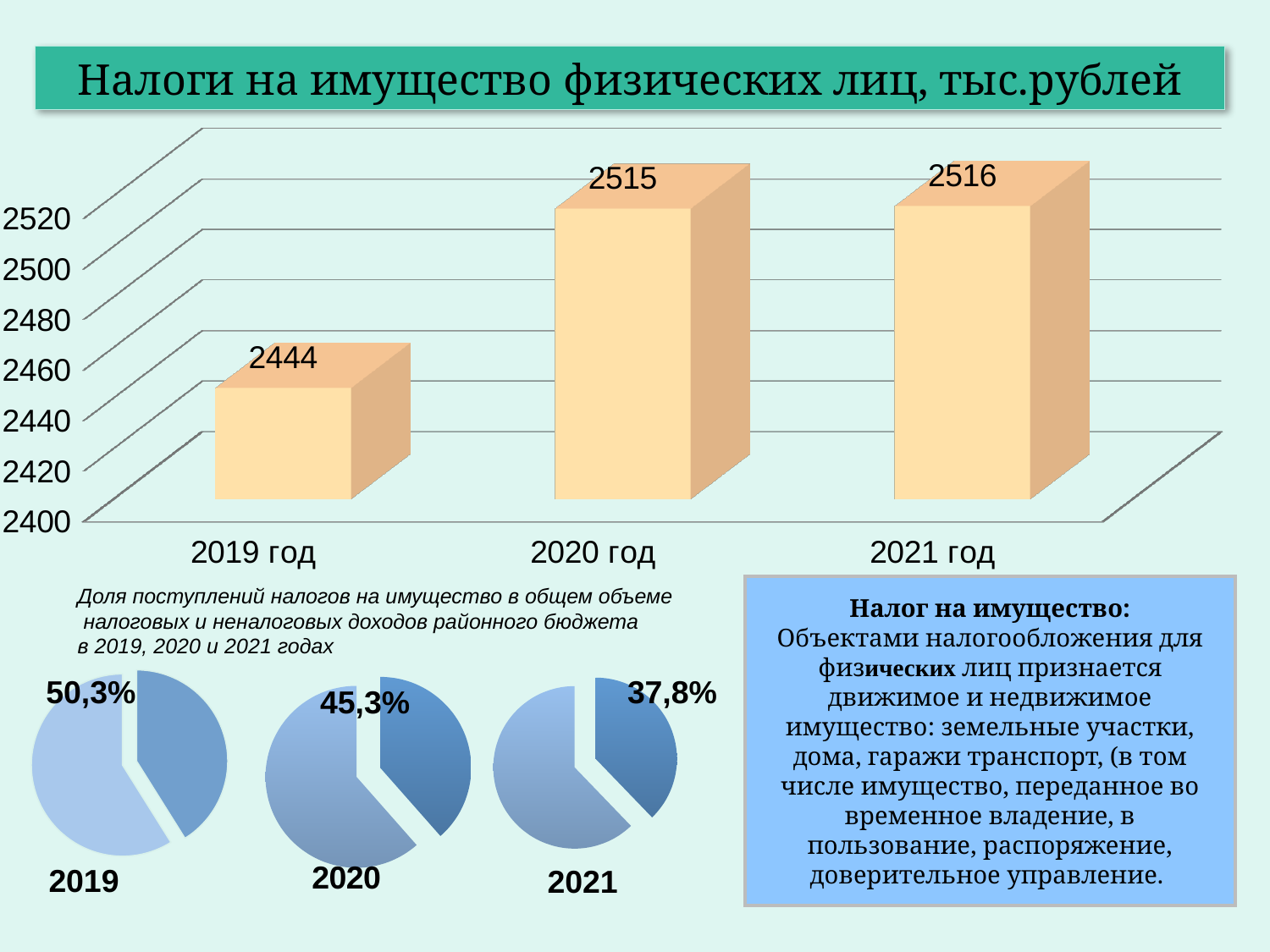
In the bar chart 'Налоги на имущество физических лиц, тыс.рублей', what is the value for 2019 год? 2444 What kind of chart is the chart titled 'Налоги на имущество физических лиц, тыс.рублей'? bar chart In the bar chart 'Налоги на имущество физических лиц, тыс.рублей', is the value for 2019 год greater or less than 2460? less In the bar chart 'Налоги на имущество физических лиц, тыс.рублей', do the values rise or fall from 2019 год to 2021 год? rise In the pie charts at the bottom left of the slide, what share is shown for 2021? 37,8% In the pie charts at the bottom left of the slide, what share is shown for 2019? 50,3% In the bar chart 'Налоги на имущество физических лиц, тыс.рублей', what is the value for 2020 год? 2515 In the bar chart 'Налоги на имущество физических лиц, тыс.рублей', what is the value for 2021 год? 2516 In the bar chart 'Налоги на имущество физических лиц, тыс.рублей', what is the difference between the values for 2020 год and 2019 год? 71 How many categories (years) does the bar chart 'Налоги на имущество физических лиц, тыс.рублей' show? 3 In the bar chart 'Налоги на имущество физических лиц, тыс.рублей', which is larger, the value for 2019 год or for 2020 год? 2020 год In the bar chart 'Налоги на имущество физических лиц, тыс.рублей', which year has the lowest value? 2019 год